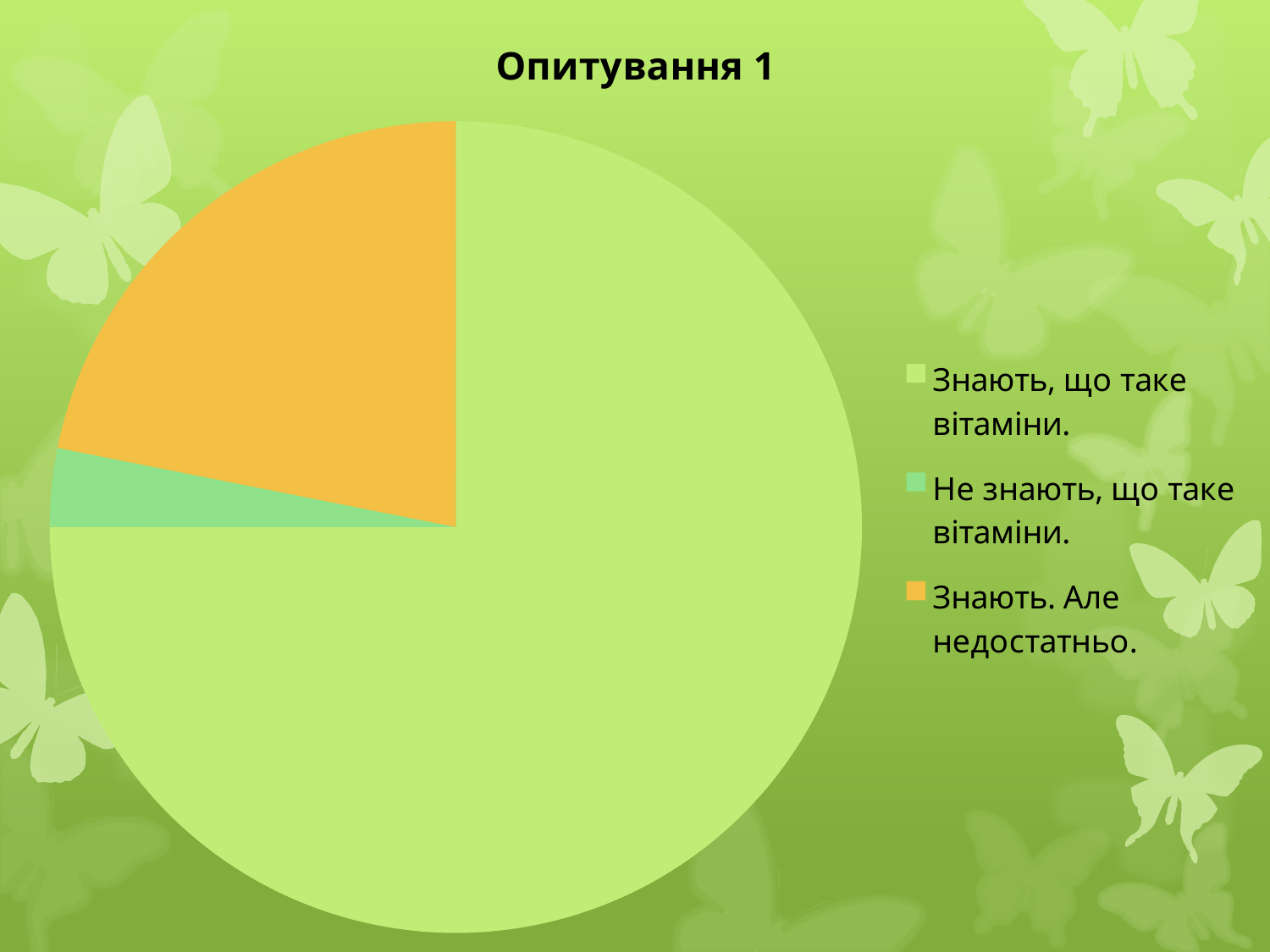
Which slice is larger: "Знають. Але недостатньо." or "Не знають, що таке вітаміни."? Знають. Але недостатньо. What is the title of the chart? Опитування 1 Which category has the largest slice of the pie? Знають, що таке вітаміни. What colour is the slice for "Знають. Але недостатньо."? orange Which category has the smallest slice of the pie? Не знають, що таке вітаміни. What kind of chart is shown on the slide? pie chart Which slice is larger: "Знають, що таке вітаміни." or "Знають. Але недостатньо."? Знають, що таке вітаміни. How many entries does the legend list? 3 How many slices does the pie chart have? 3 Does the slice for "Знають, що таке вітаміни." take up more or less than half of the pie? more